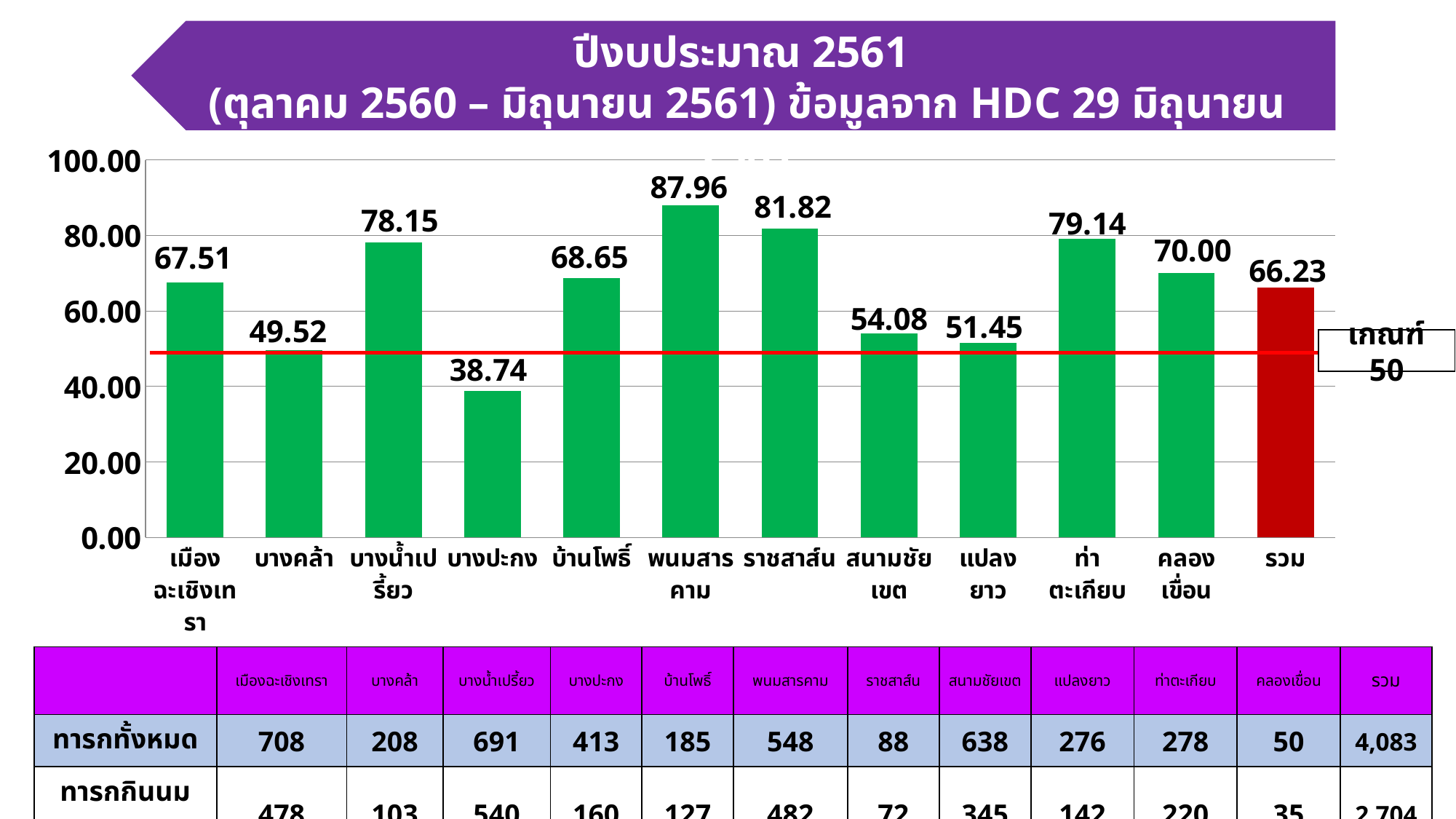
What is the value shown for คลองเขื่อน? 70.00 What is the value shown for บางปะกง? 38.74 How many categories are shown on the x axis of the chart? 12 Is the value for บางคล้า greater or less than 60? less What is the difference between the values for ราชสาส์น and สนามชัยเขต? 27.74 What is the value of the red bar labelled รวม? 66.23 Which category has the highest value in the chart? พนมสารคาม Which is larger, the value for บางน้ำเปรี้ยว or the value for ท่าตะเกียบ? ท่าตะเกียบ What is the value shown for พนมสารคาม? 87.96 What kind of chart is shown on the slide? bar chart What value does the horizontal red reference line represent, according to its label? เกณฑ์ 50 Which category has the lowest value in the chart? บางปะกง